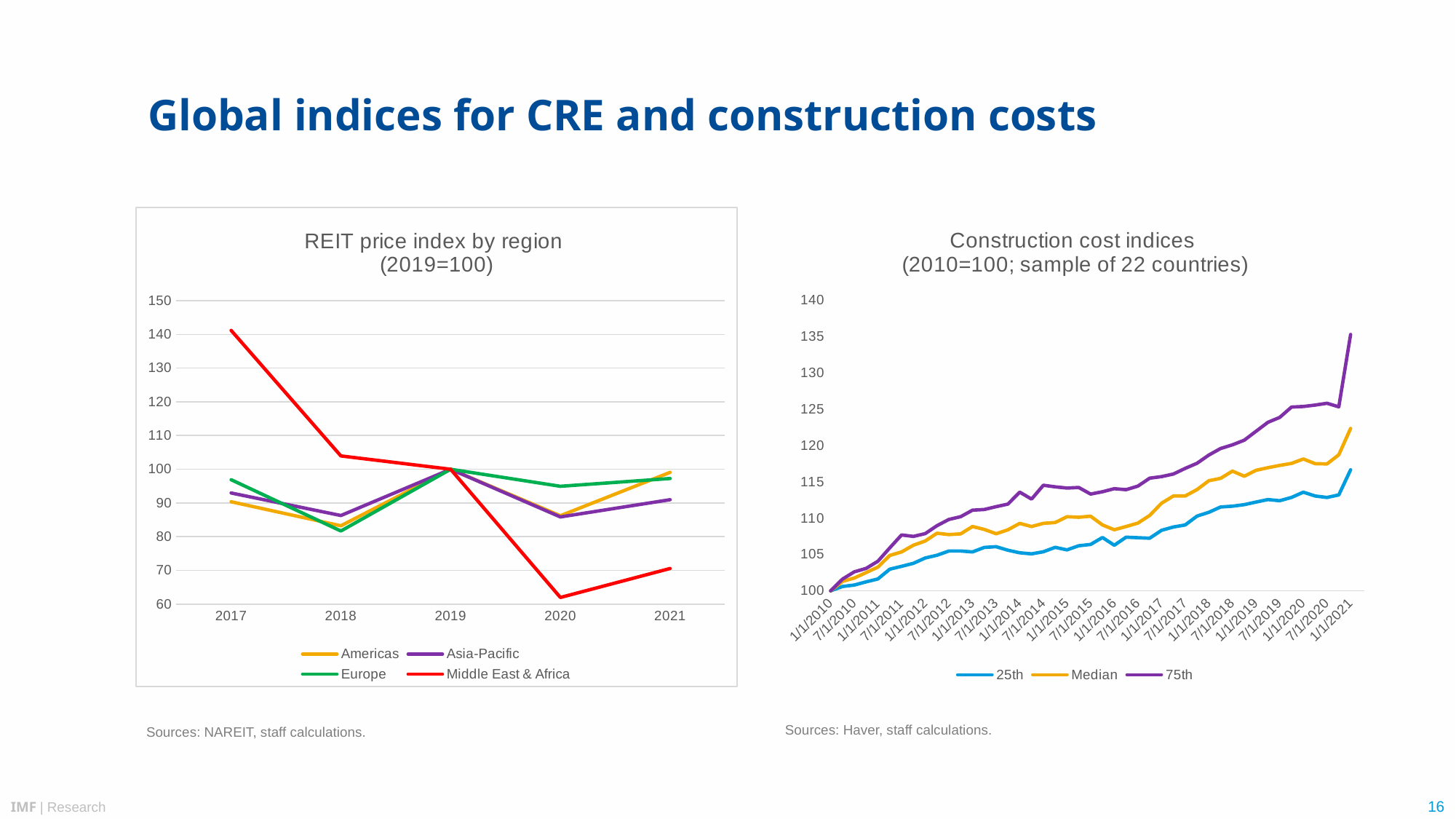
On the right chart (Construction cost indices), how many series does the legend list? 3 On the right chart (Construction cost indices), does the Median series rise or fall from 1/1/2010 to 1/1/2021? rise On the left chart (REIT price index by region), is the value for Middle East & Africa in 2020 greater or less than 70? less On the left chart (REIT price index by region), what kind of chart is shown? line chart On the left chart (REIT price index by region), which is larger in 2021, Americas or Asia-Pacific? Americas On the left chart (REIT price index by region), how many years are plotted on the x axis? 5 On the left chart (REIT price index by region), which region has the lowest value in 2020? Middle East & Africa On the left chart (REIT price index by region), which region has the highest value in 2017? Middle East & Africa On the left chart (REIT price index by region), is the value for Middle East & Africa in 2017 greater or less than 130? greater On the right chart (Construction cost indices), is the value for the 75th series at 1/1/2021 greater or less than 130? greater On the left chart (REIT price index by region), what is the value for Europe in 2019? 100 On the left chart (REIT price index by region), how many series does the legend list? 4